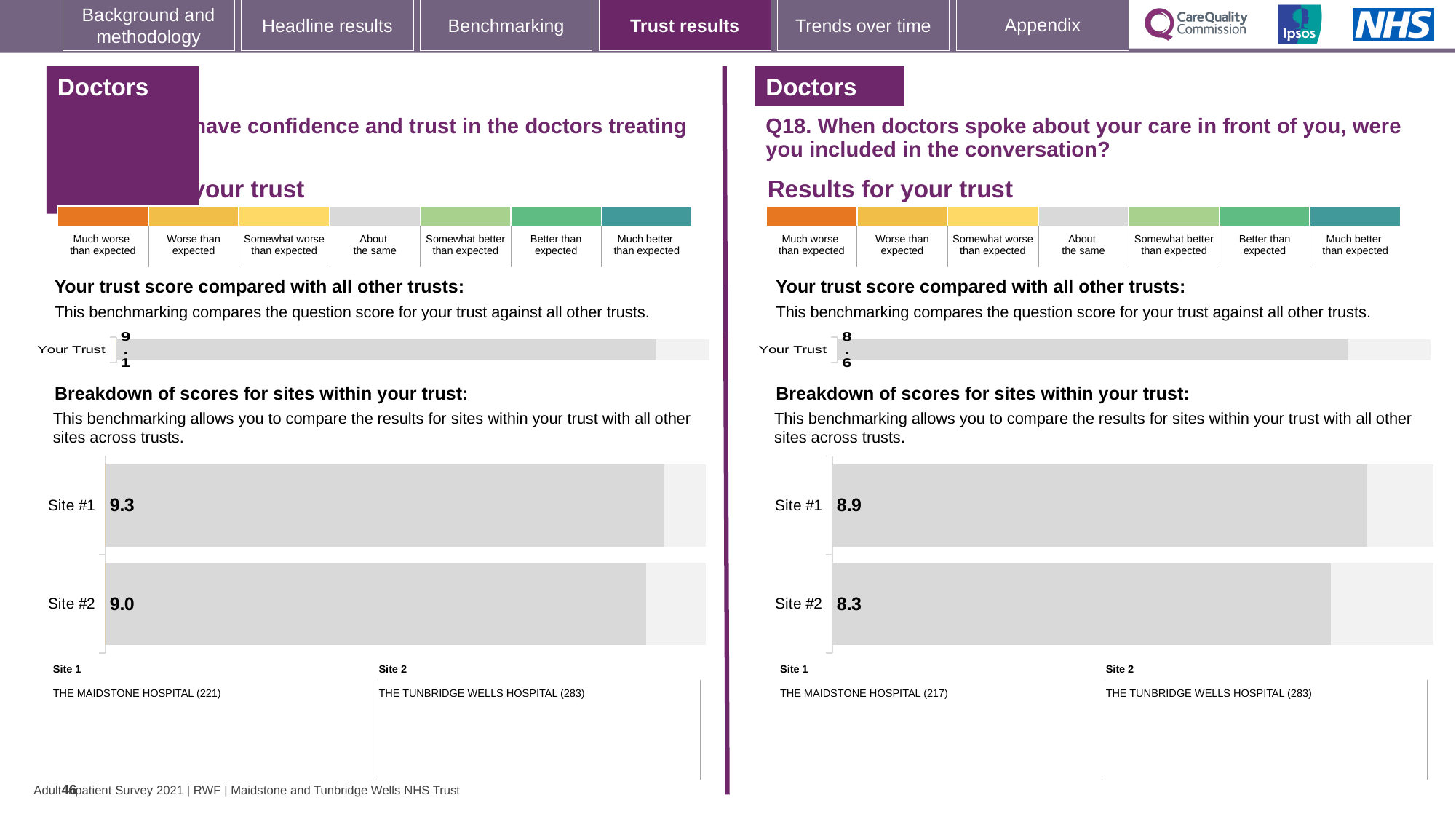
In the site breakdown chart on the left half of the slide, what is the score for Site #2? 9.0 In the Q18 site breakdown chart on the right half of the slide, what is the score for Site #2? 8.3 In the 'Your trust score compared with all other trusts' chart on the left half of the slide, what is the score for Your Trust? 9.1 In the site breakdown chart on the left half of the slide, which site has the lower score? Site #2 In the Q18 site breakdown chart on the right half of the slide, what is the difference between the Site #1 and Site #2 scores? 0.6 In the Q18 'Your trust score compared with all other trusts' chart on the right half of the slide, what is the score for Your Trust? 8.6 In the site breakdown chart on the left half of the slide, what is the score for Site #1? 9.3 In the Q18 site breakdown chart on the right half of the slide, which site has the higher score? Site #1 In the site breakdown chart on the left half of the slide, what is the difference between the Site #1 and Site #2 scores? 0.3 What type of chart is used for the site breakdown on the left half of the slide? Bar chart How many sites are shown in the Q18 site breakdown chart on the right half of the slide? 2 In the Q18 site breakdown chart on the right half of the slide, what is the score for Site #1? 8.9